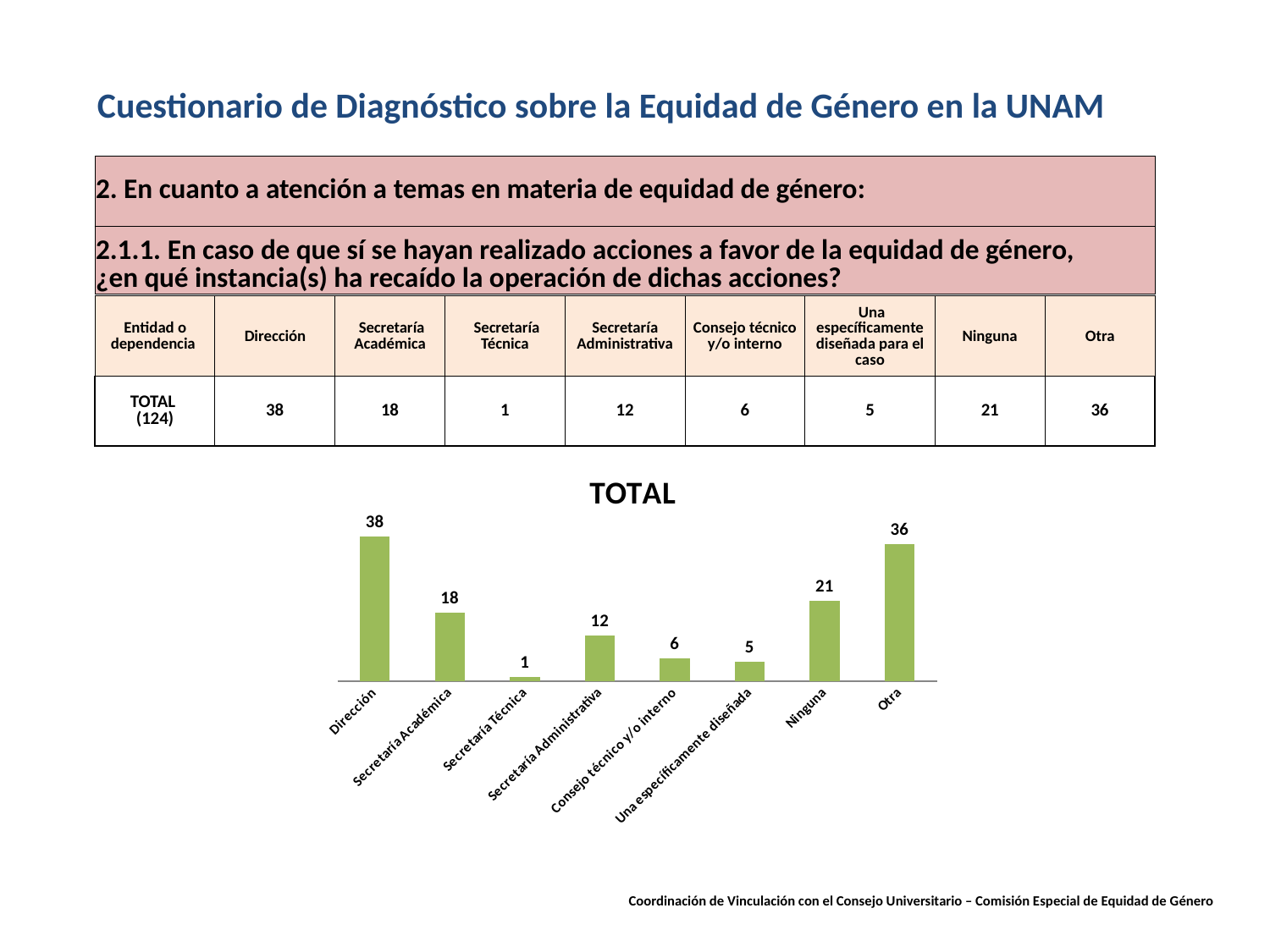
What is the difference between the values for Secretaría Académica and Secretaría Administrativa in the TOTAL chart? 6 What is the difference between the values for Dirección and Otra in the TOTAL chart? 2 How many categories are shown in the TOTAL chart? 8 Which category has the lowest value in the TOTAL chart? Secretaría Técnica What is the title of the chart on the slide? TOTAL Which category has the highest value in the TOTAL chart? Dirección What is the value for Ninguna in the TOTAL chart? 21 What is the value for Secretaría Administrativa in the TOTAL chart? 12 Which is larger in the TOTAL chart, Consejo técnico y/o interno or Una específicamente diseñada? Consejo técnico y/o interno What is the value for Dirección in the TOTAL chart? 38 What kind of chart is the TOTAL chart? Bar chart Which is larger in the TOTAL chart, Ninguna or Secretaría Académica? Ninguna